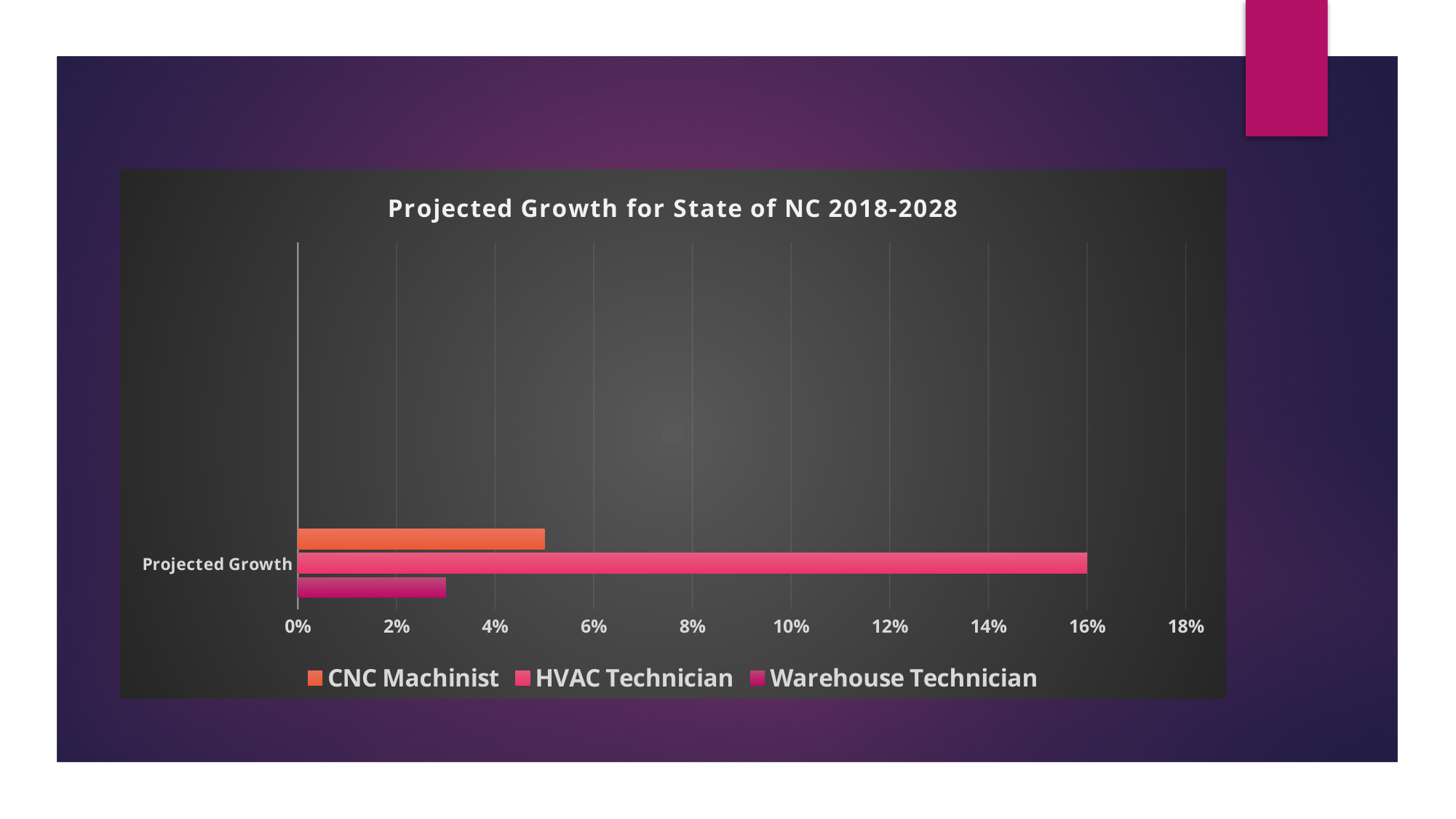
What kind of chart is shown on the slide? bar chart Which series has the highest projected growth? HVAC Technician Which is larger, the projected growth for CNC Machinist or for Warehouse Technician? CNC Machinist Which series has the lowest projected growth? Warehouse Technician What is the chart's title? Projected Growth for State of NC 2018-2028 Is the projected growth for CNC Machinist greater or less than 4%? greater Is the projected growth for CNC Machinist greater or less than 6%? less Is the projected growth for Warehouse Technician greater or less than 4%? less Which is larger, the projected growth for HVAC Technician or for CNC Machinist? HVAC Technician What is the projected growth for HVAC Technician? 16% What is the label of the single category on the vertical axis? Projected Growth How many series does the legend list? 3